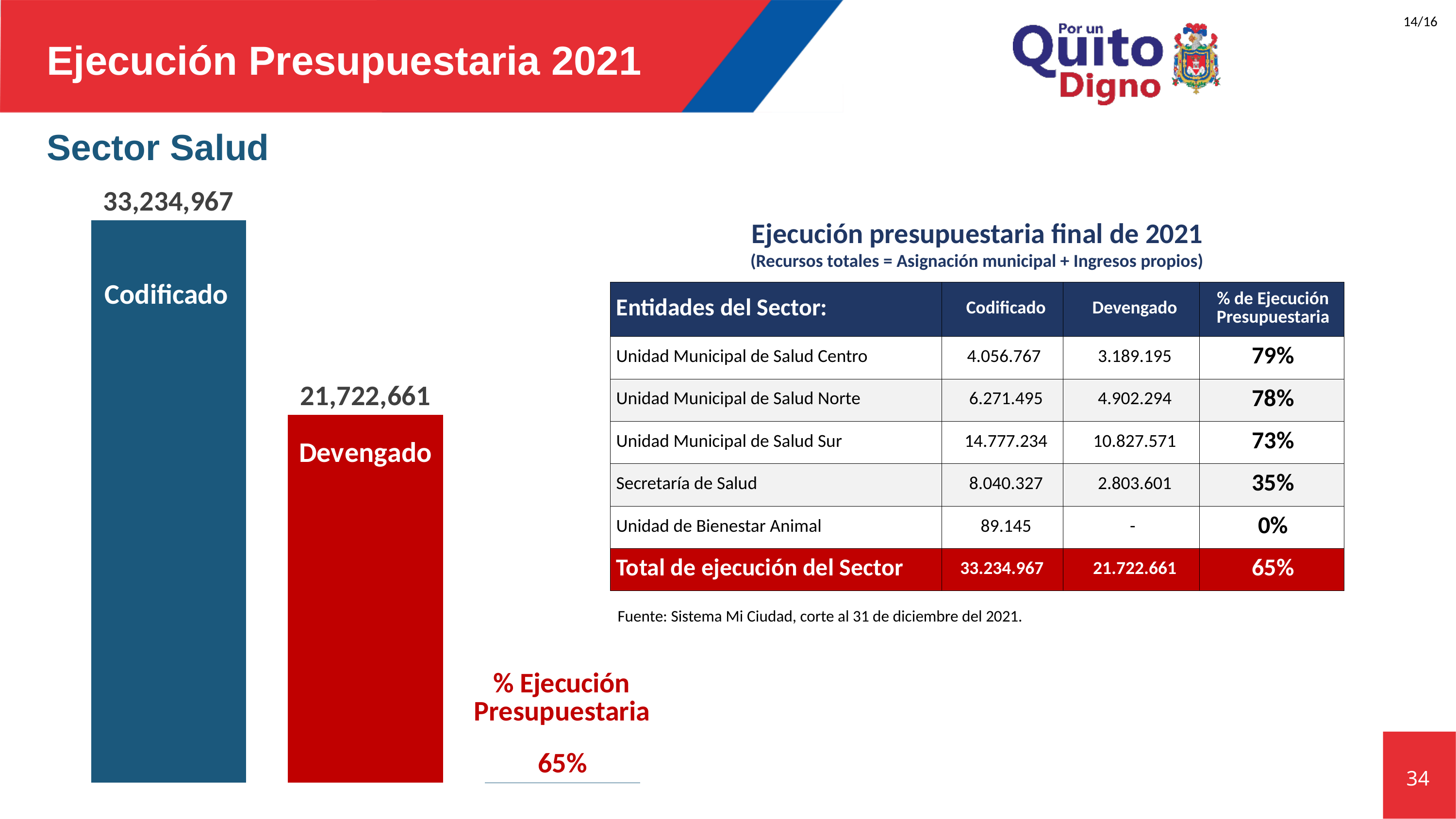
Which bar in the Sector Salud chart is the highest? Codificado What is the difference between the Codificado and Devengado bars in the Sector Salud chart? 11,512,306 Which bar in the Sector Salud chart is the lowest? Devengado In the Sector Salud chart, which is larger, Codificado or Devengado? Codificado What colour is the Codificado bar in the Sector Salud chart? Blue How many bars are shown in the Sector Salud chart? 2 What is the value of the Codificado bar in the Sector Salud chart? 33,234,967 What percentage of budget execution (% Ejecución Presupuestaria) is shown next to the Sector Salud bar chart? 65% What kind of chart is shown on the left of the slide under Sector Salud? Bar chart What colour is the Devengado bar in the Sector Salud chart? Red What is the value of the Devengado bar in the Sector Salud chart? 21,722,661